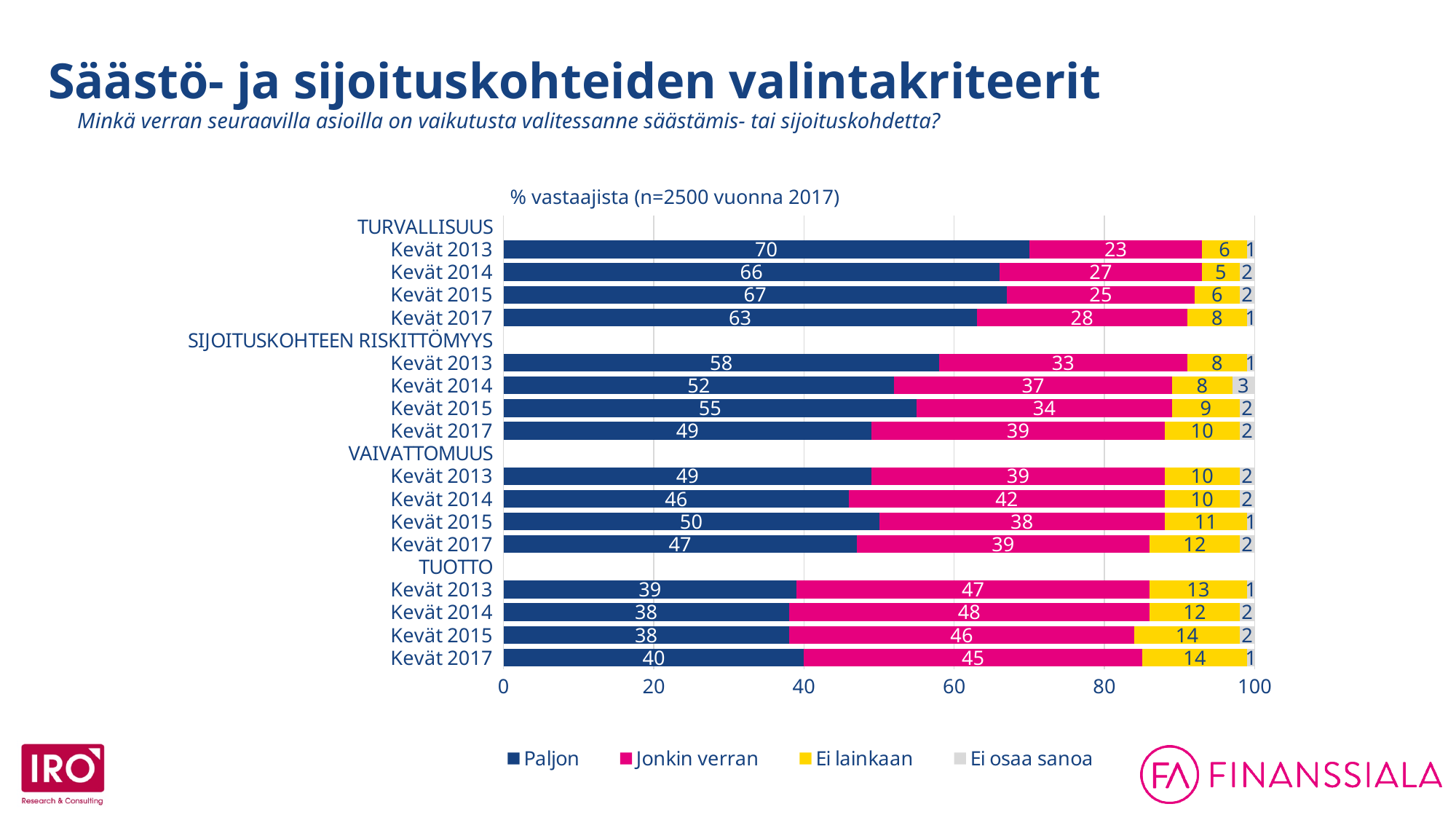
What is the difference between the "Paljon" values for TURVALLISUUS in Kevät 2013 and Kevät 2017? 7 What is the total of the "Paljon" and "Jonkin verran" values for TUOTTO in Kevät 2017? 85 How many series does the legend list? 4 What is the "Ei osaa sanoa" value for SIJOITUSKOHTEEN RISKITTÖMYYS in Kevät 2014? 3 How does the "Paljon" value for SIJOITUSKOHTEEN RISKITTÖMYYS change from Kevät 2013 to Kevät 2017? It falls from 58 to 49 What is the "Jonkin verran" value for TUOTTO in Kevät 2014? 48 What is the "Paljon" value for TURVALLISUUS in Kevät 2013? 70 Which is larger: the "Jonkin verran" value for VAIVATTOMUUS Kevät 2014 or for SIJOITUSKOHTEEN RISKITTÖMYYS Kevät 2014? VAIVATTOMUUS Kevät 2014 What kind of chart is shown on the slide? Stacked bar chart Which TUOTTO year has the lowest "Paljon" value? Kevät 2014 and Kevät 2015 (both 38) Which bar has the highest "Paljon" value? TURVALLISUUS Kevät 2013 What is the "Ei lainkaan" value for VAIVATTOMUUS in Kevät 2017? 12